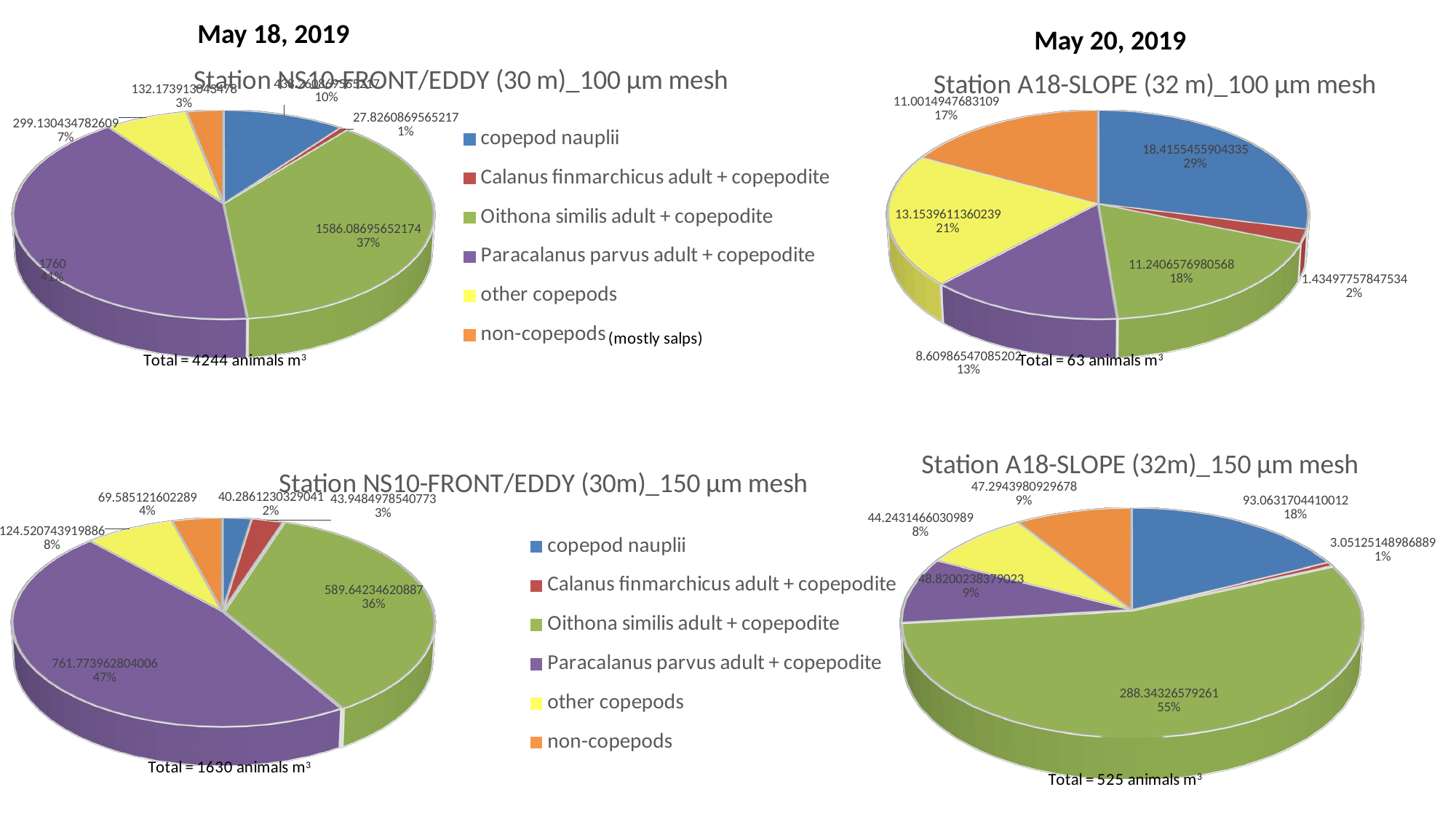
What kind of chart is the Station A18-SLOPE (32m)_150 µm mesh chart? pie chart In the Station NS10-FRONT/EDDY (30m)_150 µm mesh chart, what is the difference in percentage share between Paracalanus parvus adult + copepodite and Oithona similis adult + copepodite? 11% How many categories does the legend of the Station NS10-FRONT/EDDY (30m)_150 µm mesh chart list? 6 In the Station A18-SLOPE (32m)_150 µm mesh chart, which category has the smallest slice? Calanus finmarchicus adult + copepodite In the Station A18-SLOPE (32 m)_100 µm mesh chart, what percentage share does copepod nauplii have? 29% In the Station NS10-FRONT/EDDY (30 m)_100 µm mesh chart, which category has the largest slice? Paracalanus parvus adult + copepodite In the Station NS10-FRONT/EDDY (30m)_150 µm mesh chart, what is the value for Paracalanus parvus adult + copepodite? 761.773962804006 In the Station A18-SLOPE (32 m)_100 µm mesh chart, what is the value for other copepods? 13.1539611360239 In the Station NS10-FRONT/EDDY (30 m)_100 µm mesh chart, what is the value for Paracalanus parvus adult + copepodite? 1760 What total is stated below the Station A18-SLOPE (32 m)_100 µm mesh chart? Total = 63 animals m³ In the Station A18-SLOPE (32 m)_100 µm mesh chart, which is larger: the share for other copepods or the share for non-copepods? other copepods In the Station A18-SLOPE (32m)_150 µm mesh chart, what percentage share does Oithona similis adult + copepodite have? 55%